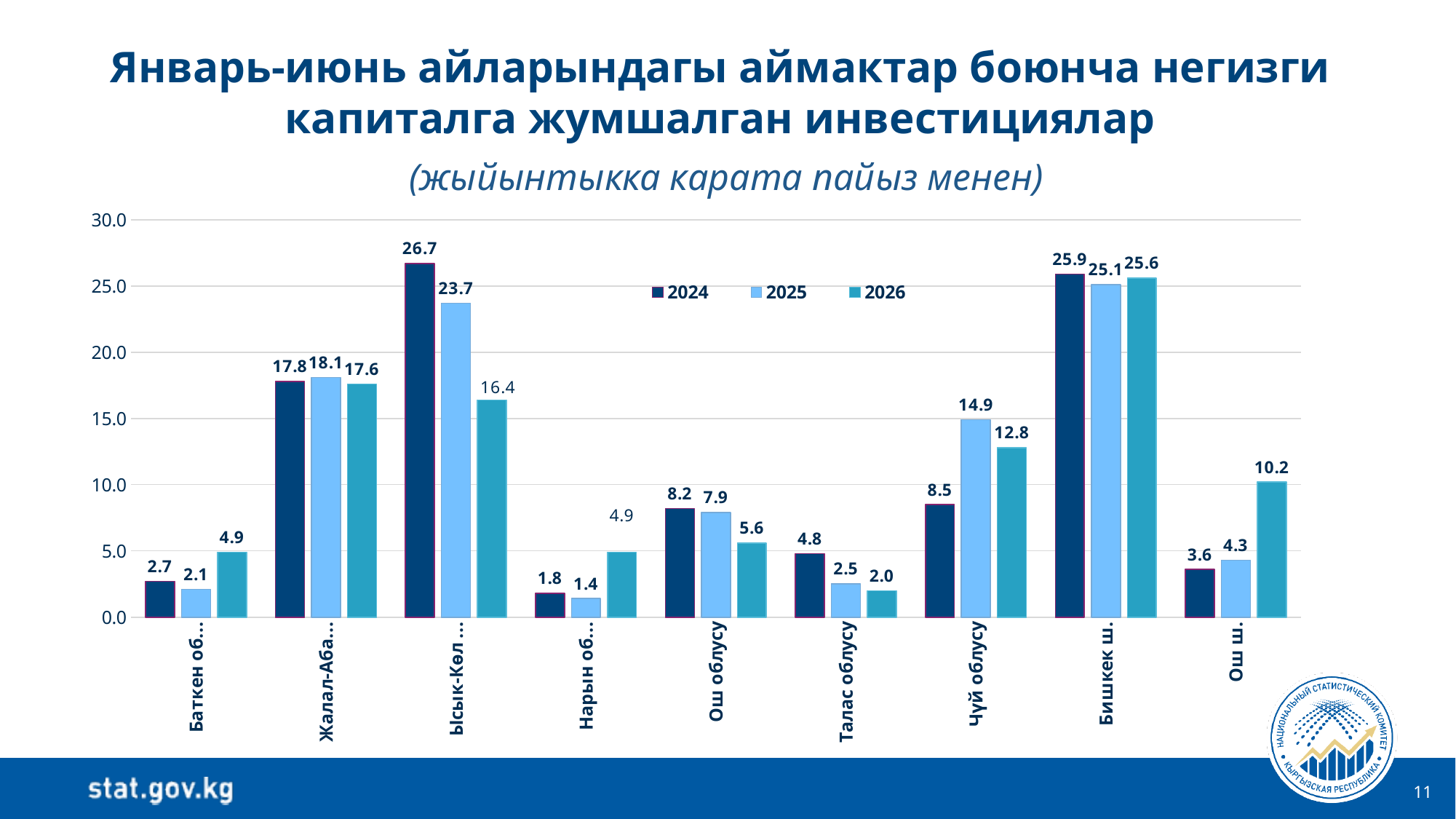
What is the 2025 value for Ош облусу? 7.9 What is the difference between the 2024 and 2026 values for Ысык-Көл? 10.3 Which region has the lowest 2025 value? Нарын What is the 2026 value for Талас облусу? 2.0 How many series does the legend list? 3 Do the values for Талас облусу rise or fall from 2024 to 2026? fall Which is larger for Чүй облусу: the 2024 value or the 2026 value? 2026 How many regions (categories) are shown on the x axis? 9 What is the 2025 value for Чүй облусу? 14.9 What kind of chart is shown on the slide? bar chart Which region has the highest 2024 value? Ысык-Көл What is the 2024 value for Бишкек ш.? 25.9